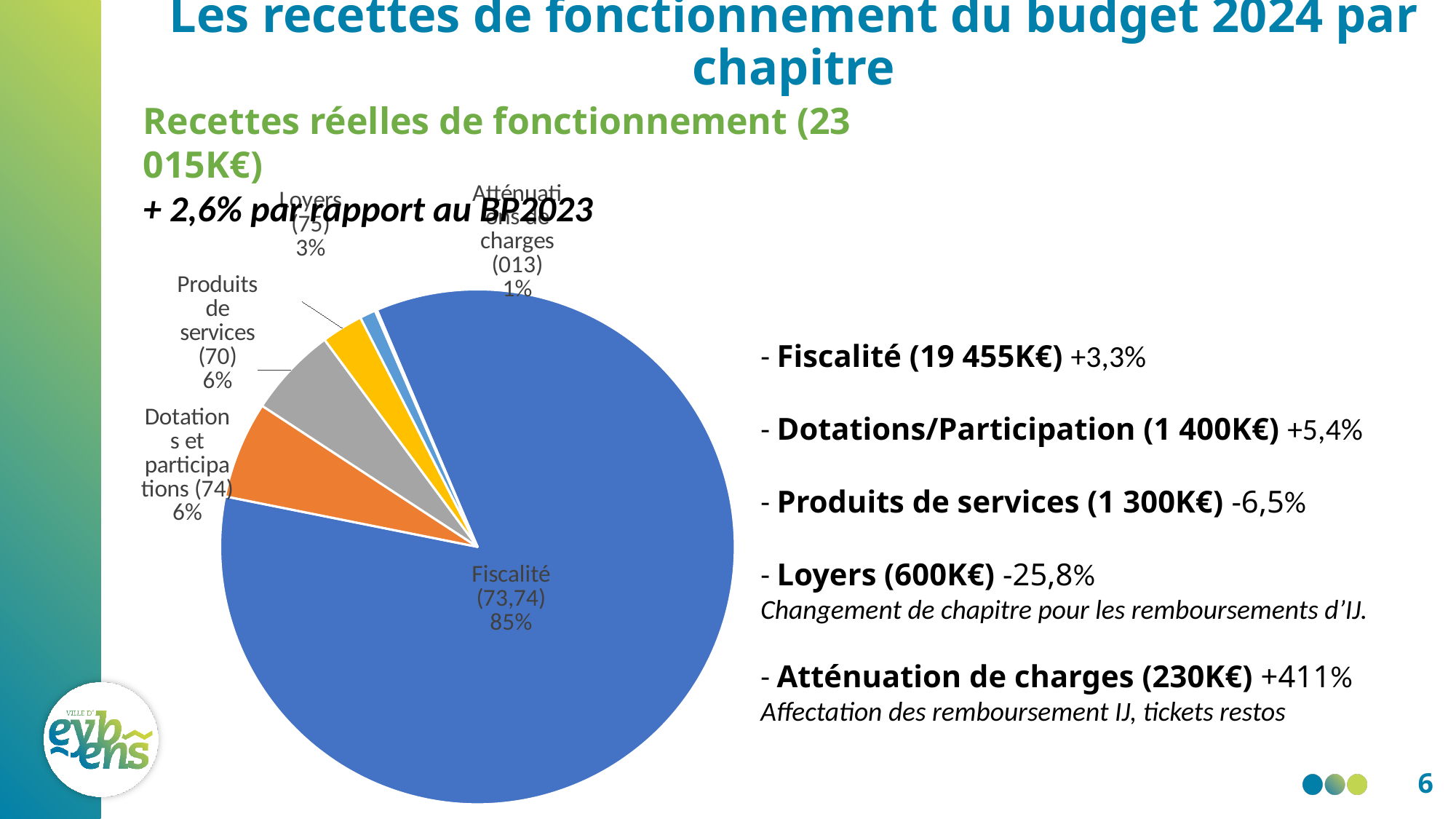
Which category has the largest slice of the pie? Fiscalité (73,74) What percentage is shown for Dotations et participations (74)? 6% What colour is the Fiscalité (73,74) slice? blue What percentage is shown for Produits de services (70)? 6% What percentage is shown for Loyers (75)? 3% What percentage is shown for Atténuations de charges (013)? 1% What share of the pie does Fiscalité (73,74) represent? 85% What kind of chart is shown on the slide? pie chart What is the difference in percentage points between the Fiscalité (73,74) slice and the Loyers (75) slice? 82 Which is larger, the slice for Fiscalité (73,74) or the slice for Loyers (75)? Fiscalité (73,74)